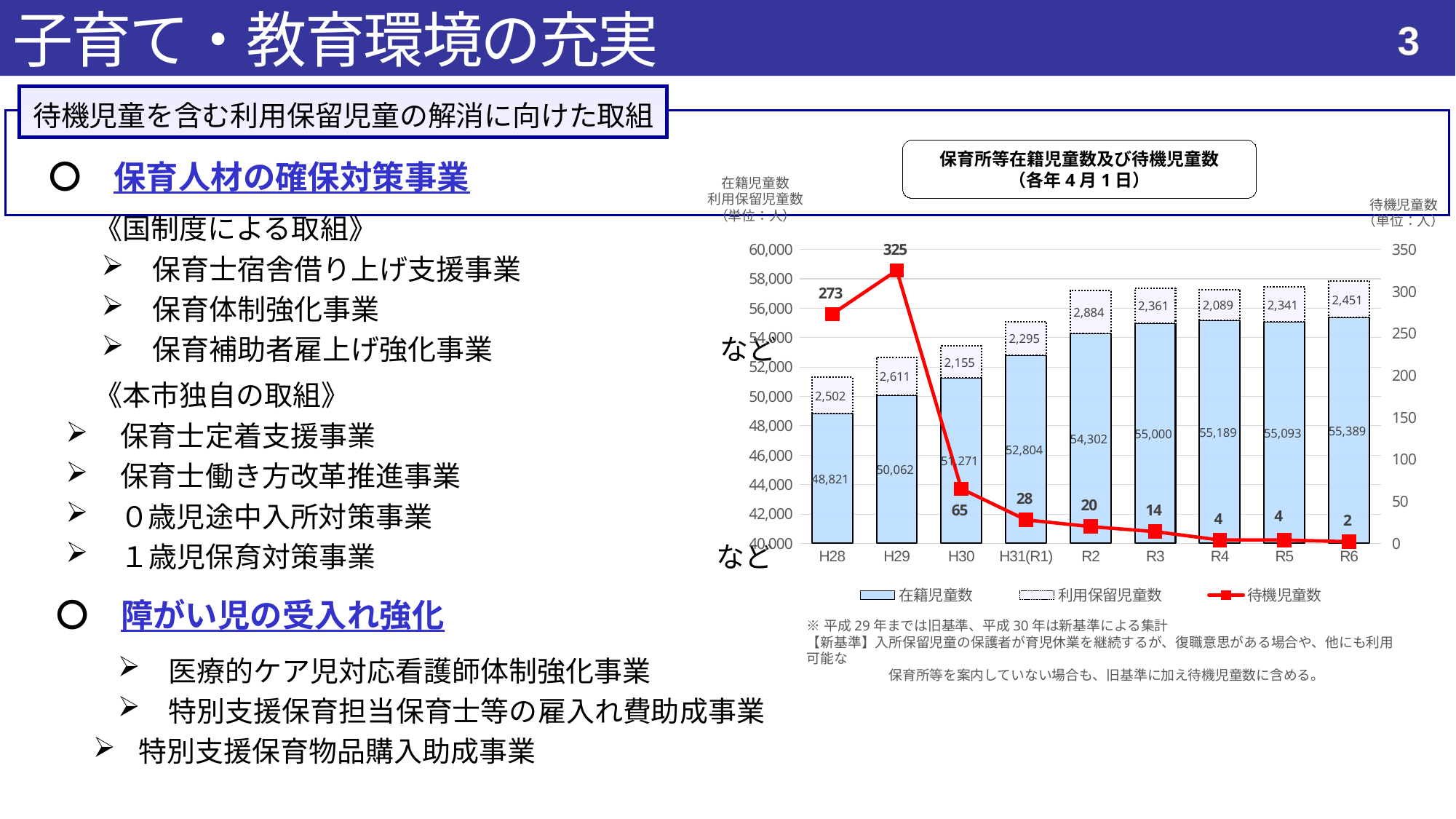
Which year has the lowest 在籍児童数? H28 Does the 待機児童数 line rise or fall from H29 to R6? Fall Which year has the lowest 待機児童数? R6 What is the 利用保留児童数 value for R2? 2,884 What is the difference in 待機児童数 between H29 and H30? 260 How many series does the legend list? 3 What is the 待機児童数 value for H29? 325 Which is larger, the 利用保留児童数 for H29 or for R4? H29 What is the 在籍児童数 value for R6? 55,389 How many years are shown on the x axis? 9 Which year has the highest 待機児童数? H29 What kind of chart is this? Combined bar and line chart